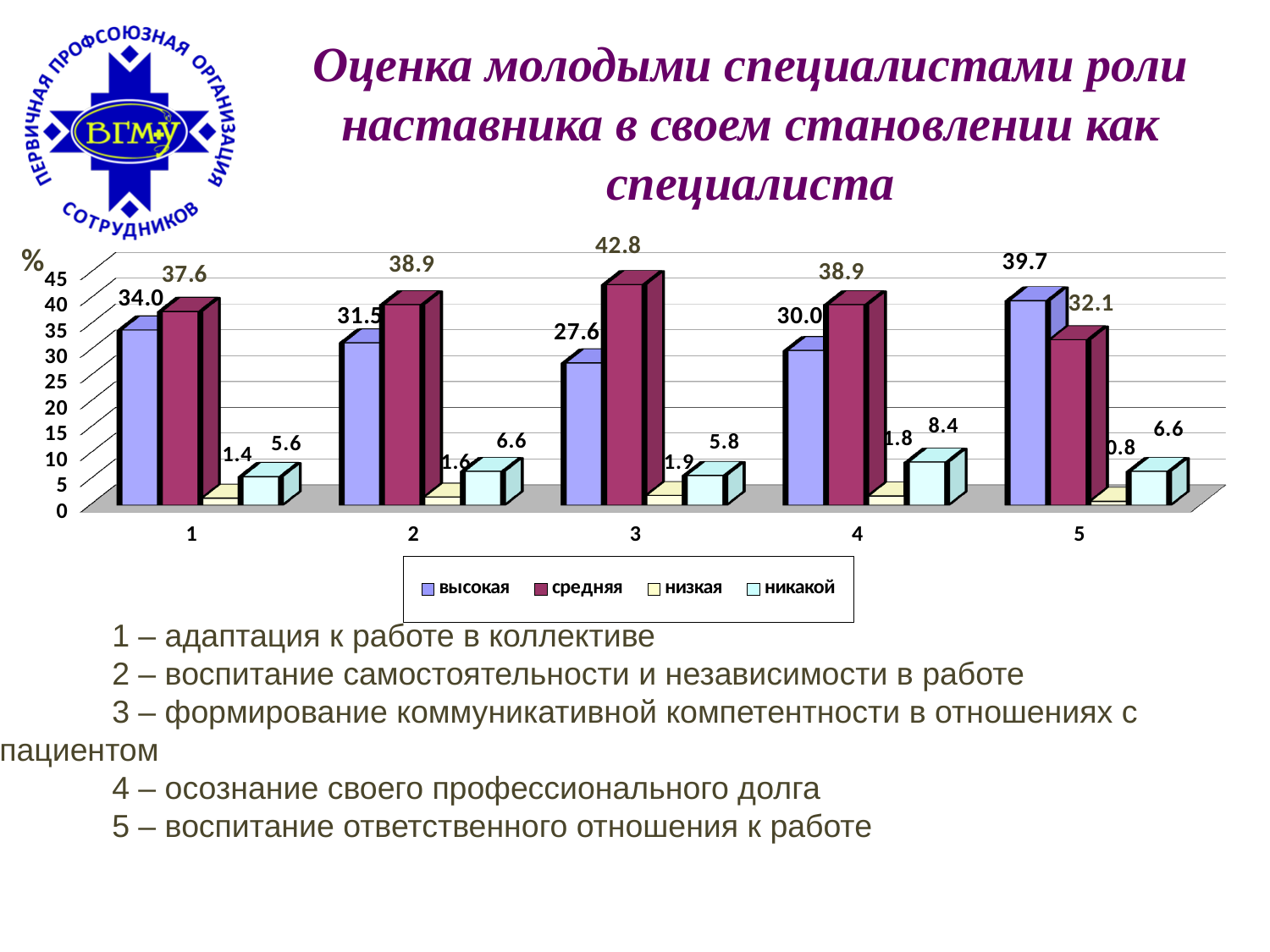
What is the difference between the 'средняя' and 'высокая' values for category 3? 15.2 How many series does the legend list? 4 How many categories are shown on the x axis? 5 What label is shown on the vertical axis of the chart? % What is the value of the 'низкая' series for category 5? 0.8 For category 5, which is larger: the 'высокая' value or the 'средняя' value? высокая What is the value of the 'средняя' series for category 3? 42.8 Which category has the highest value for the 'средняя' series? 3 Which category has the lowest value for the 'низкая' series? 5 What is the value of the 'никакой' series for category 4? 8.4 What kind of chart is shown on the slide? bar chart What is the value of the 'высокая' series for category 1? 34.0